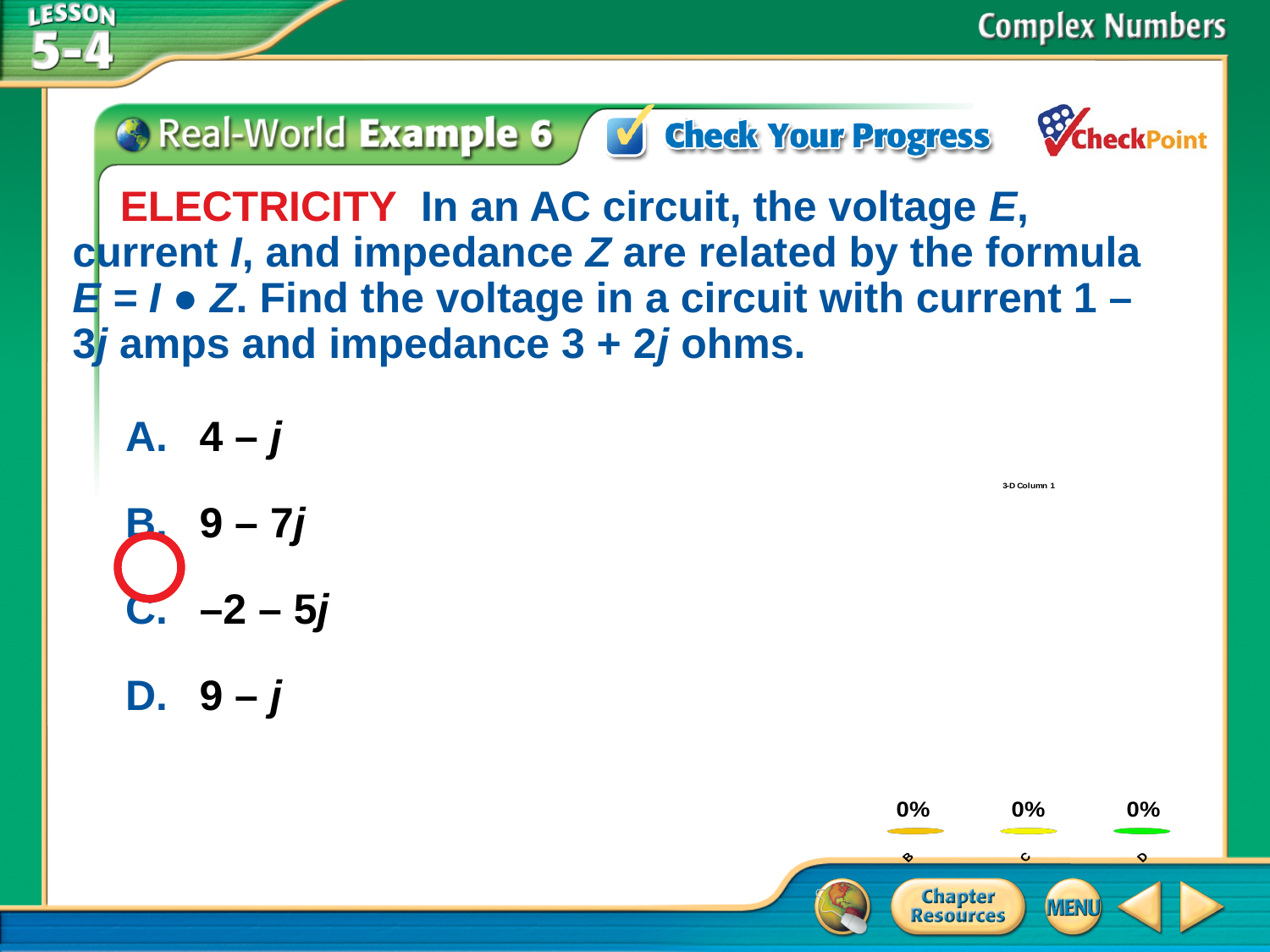
Is the value for C in the chart greater or less than 50%? less What value is shown for category B in the chart? 0% What value is shown for category C in the chart? 0% What kind of chart is shown on the slide? bar chart Do the values in the chart rise, fall, or stay the same from B to D? stay the same What is the title of the chart on the slide? 3-D Column 1 What value is shown for category D in the chart? 0% What is the difference between the values for B and D in the chart? 0%